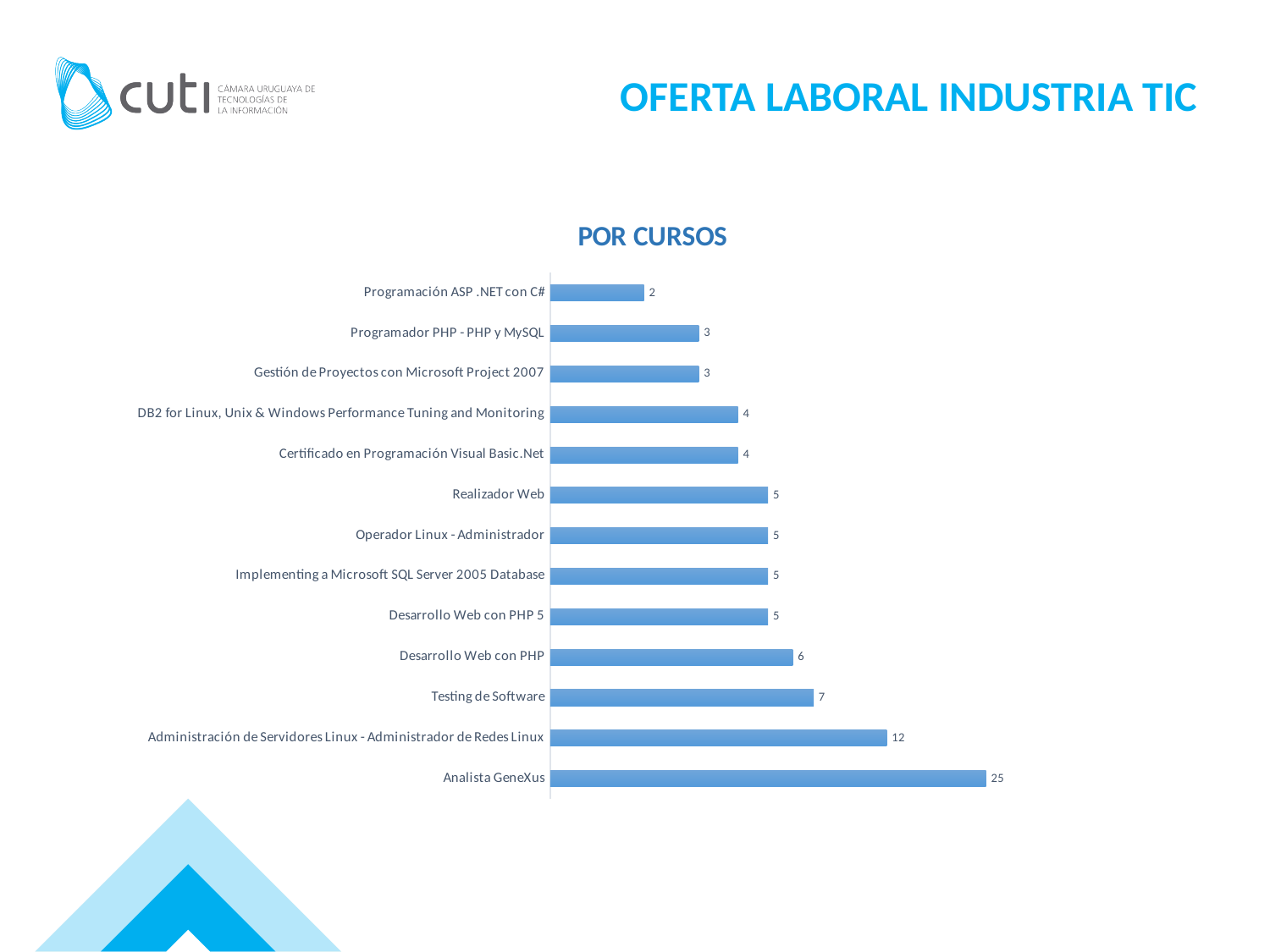
Which course has the lowest value? Programación ASP .NET con C# Which course has the highest value? Analista GeneXus How many courses are shown in the chart? 13 What is the value for Administración de Servidores Linux - Administrador de Redes Linux? 12 What is the difference between the values for Desarrollo Web con PHP and Programador PHP - PHP y MySQL? 3 What kind of chart is shown on the slide? Bar chart Which is larger, the value for Desarrollo Web con PHP or the value for Testing de Software? Testing de Software What is the difference between the values for Analista GeneXus and Administración de Servidores Linux - Administrador de Redes Linux? 13 What is the value for Testing de Software? 7 What is the value for Analista GeneXus? 25 What is the value for Programación ASP .NET con C#? 2 What is the title of the chart? POR CURSOS